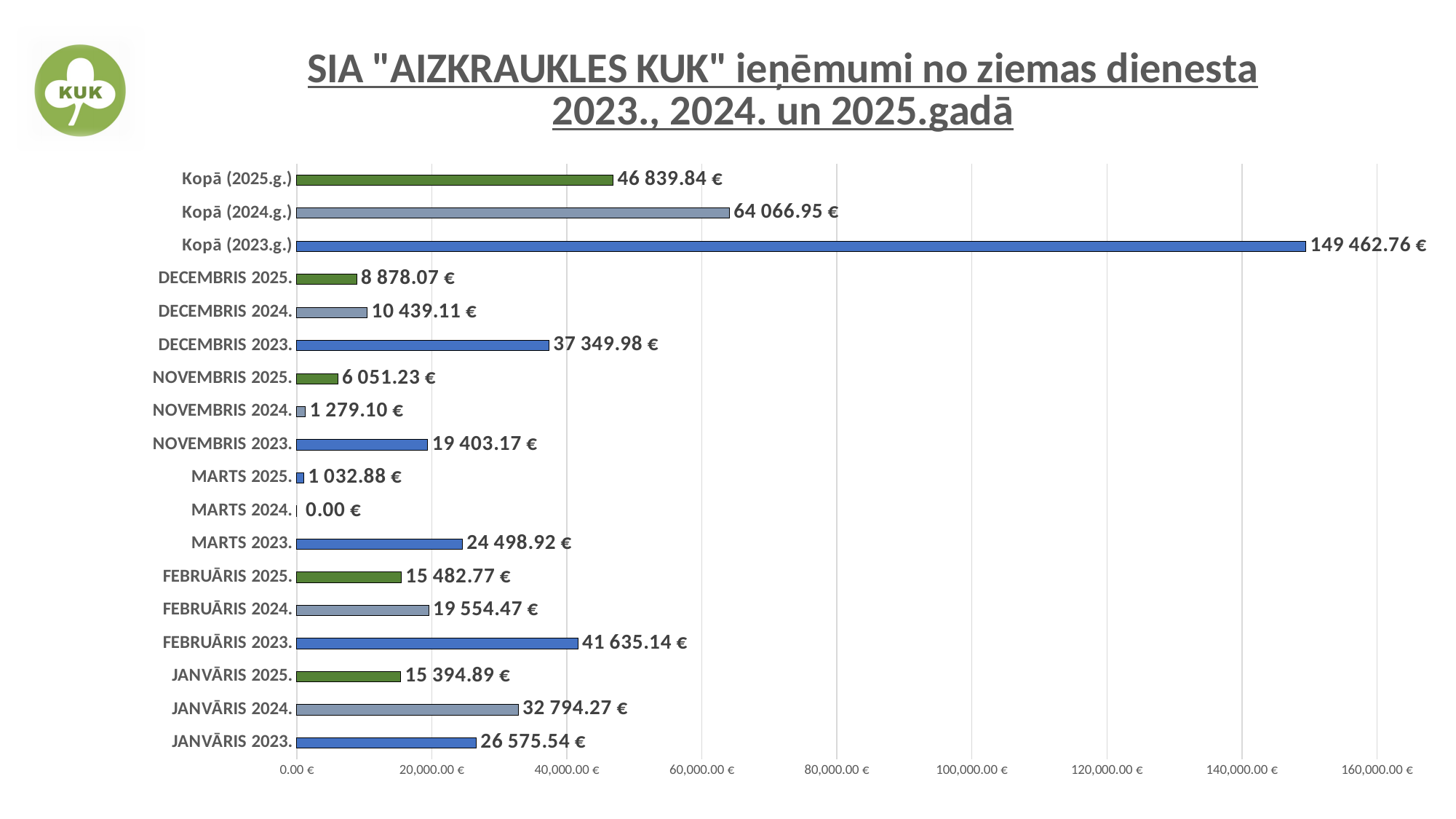
What is the value for DECEMBRIS 2024.? 10 439.11 € What is the value for NOVEMBRIS 2025.? 6 051.23 € Which category has the highest value? Kopā (2023.g.) Which category has the lowest value? MARTS 2024. What kind of chart is shown on the slide? bar chart How many bars are shown in the chart? 18 What is the value for JANVĀRIS 2024.? 32 794.27 € What is the value for Kopā (2023.g.)? 149 462.76 € What is the difference between DECEMBRIS 2023. and DECEMBRIS 2024.? 26 910.87 € What is the difference between Kopā (2024.g.) and Kopā (2025.g.)? 17 227.11 € Which is larger, MARTS 2023. or NOVEMBRIS 2023.? MARTS 2023. Is the value for FEBRUĀRIS 2023. greater or less than 40,000.00 €? greater